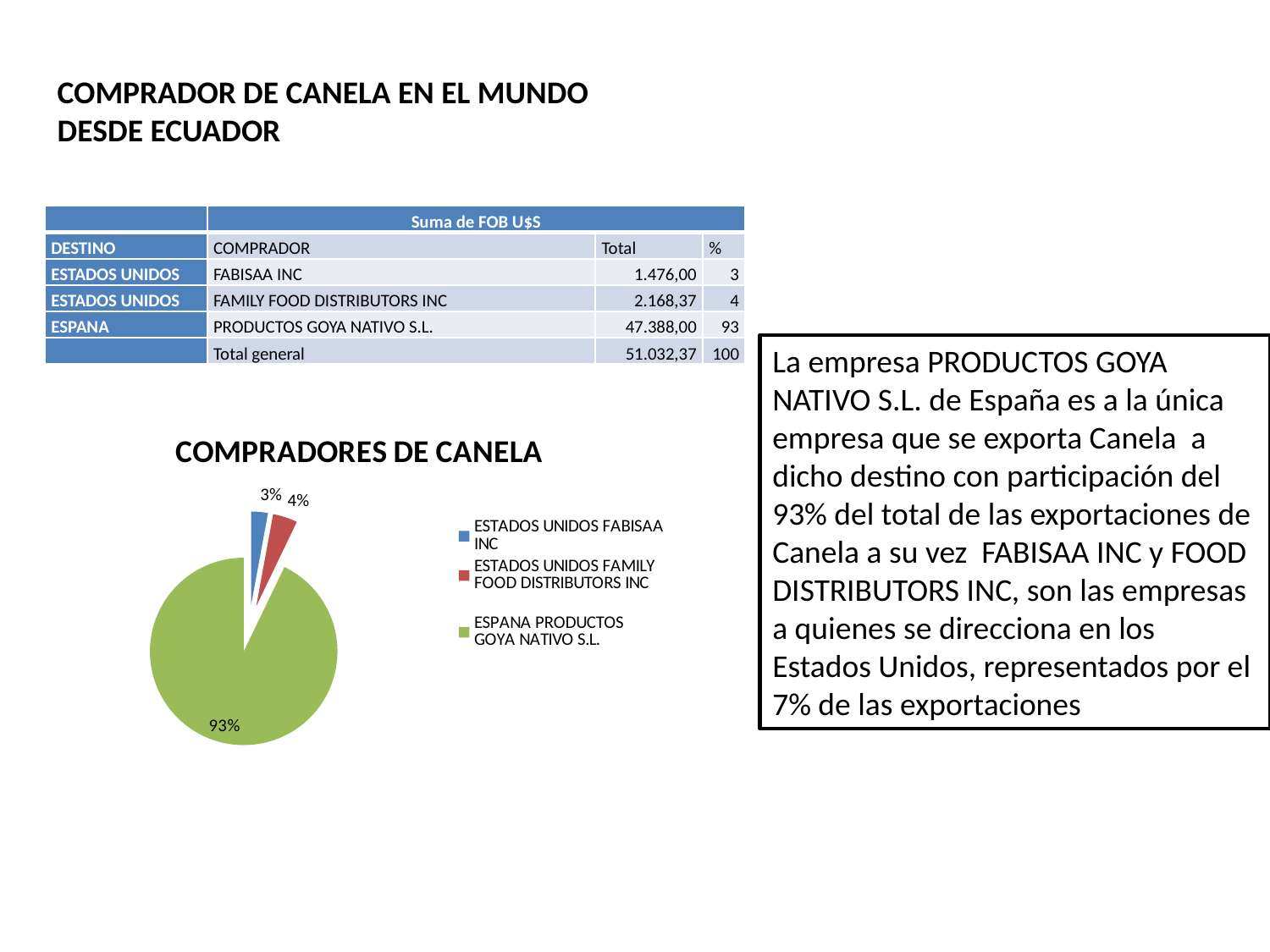
Which buyer has the smallest slice of the pie? ESTADOS UNIDOS FABISAA INC What share of the pie does ESTADOS UNIDOS FAMILY FOOD DISTRIBUTORS INC hold? 4% Which slice is larger: ESTADOS UNIDOS FABISAA INC or ESTADOS UNIDOS FAMILY FOOD DISTRIBUTORS INC? ESTADOS UNIDOS FAMILY FOOD DISTRIBUTORS INC What colour is the slice for ESPANA PRODUCTOS GOYA NATIVO S.L.? green What share of the pie does ESTADOS UNIDOS FABISAA INC hold? 3% How many entries does the chart legend list? 3 What type of chart is shown on the slide? pie chart What is the title of the chart? COMPRADORES DE CANELA How many slices does the pie chart have? 3 What is the difference in percentage points between the ESPANA PRODUCTOS GOYA NATIVO S.L. slice and the ESTADOS UNIDOS FAMILY FOOD DISTRIBUTORS INC slice? 89 percentage points What share of the pie does ESPANA PRODUCTOS GOYA NATIVO S.L. hold? 93% Which buyer has the largest slice of the pie? ESPANA PRODUCTOS GOYA NATIVO S.L.